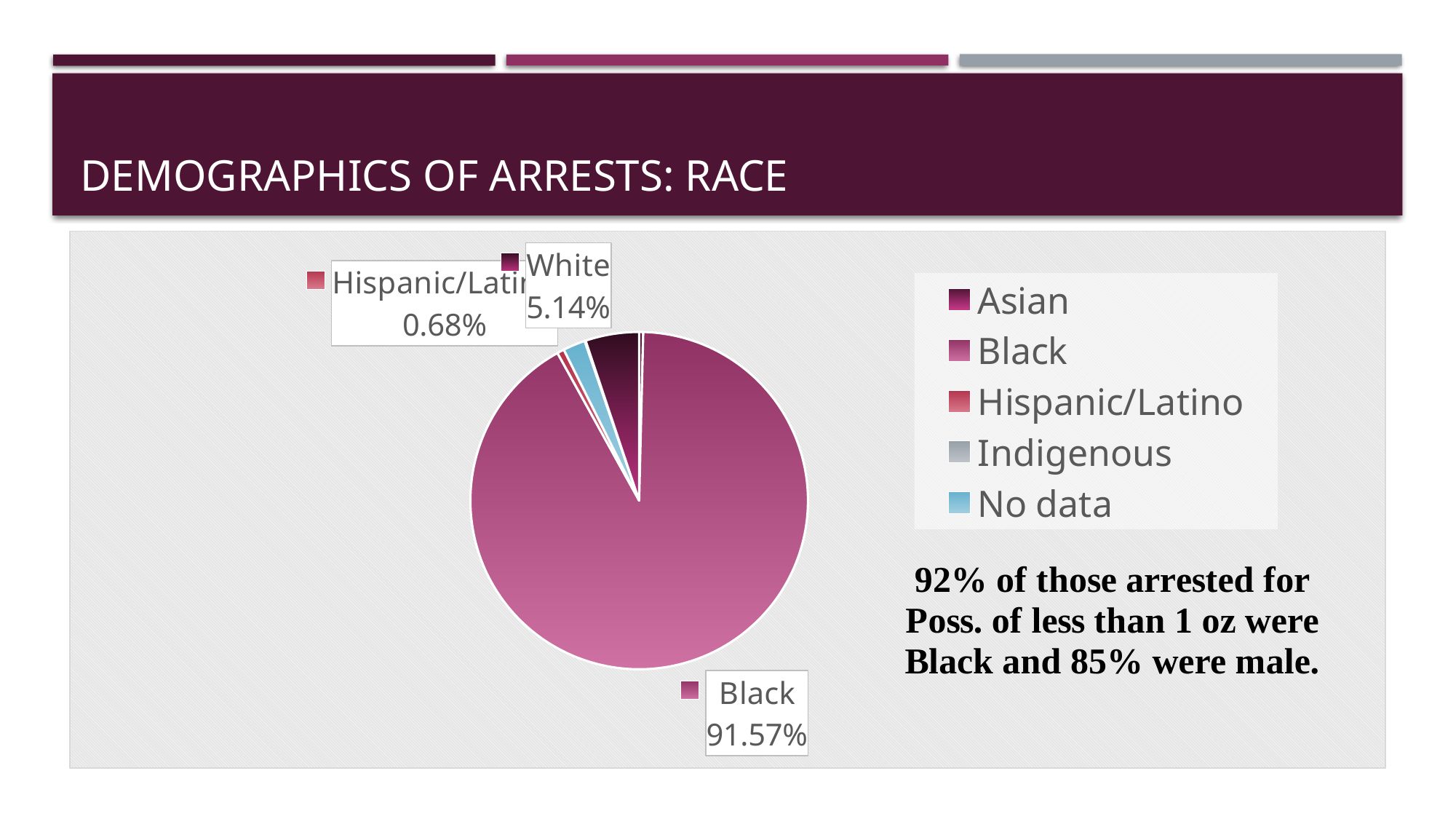
How many entries does the legend list? 5 Which slice is larger, White or Hispanic/Latino? White What percentage is shown for the Hispanic/Latino slice? 0.68% What is the title of the slide containing the chart? Demographics of Arrests: Race What colour is the No data slice in the legend? light blue What percentage of arrests does the Black slice represent? 91.57% What percentage is shown for the White slice? 5.14% What is the difference between the White and Hispanic/Latino percentages? 4.46% What is the difference between the Black and White percentages? 86.43% What kind of chart is shown on the slide? pie chart Which slice is larger, Black or White? Black Which category has the largest slice of the pie? Black